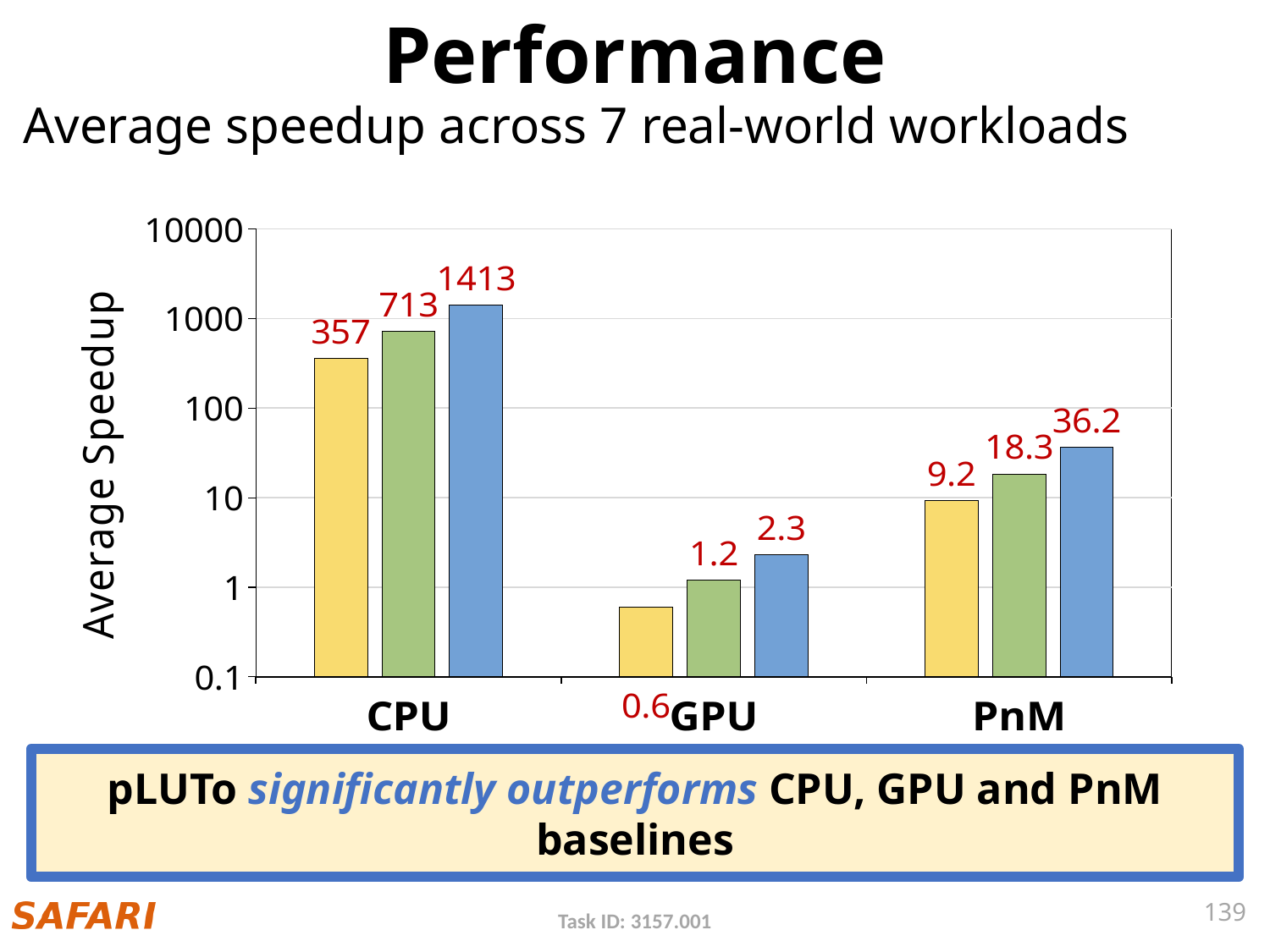
What is the difference between the blue bar and the green bar for PnM? 17.9 How many categories are shown on the x axis? 3 What kind of chart is shown on the slide? bar chart What is the value of the yellow bar for PnM? 9.2 What is the label of the y axis? Average Speedup Which category has the highest average speedup value? CPU What is the value of the yellow bar for GPU? 0.6 What is the value of the blue bar for CPU? 1413 What is the difference between the blue bar and the yellow bar for CPU? 1056 Which category has the lowest average speedup value? GPU What is the value of the green bar for PnM? 18.3 Which is larger: the green bar for CPU or the blue bar for PnM? the green bar for CPU